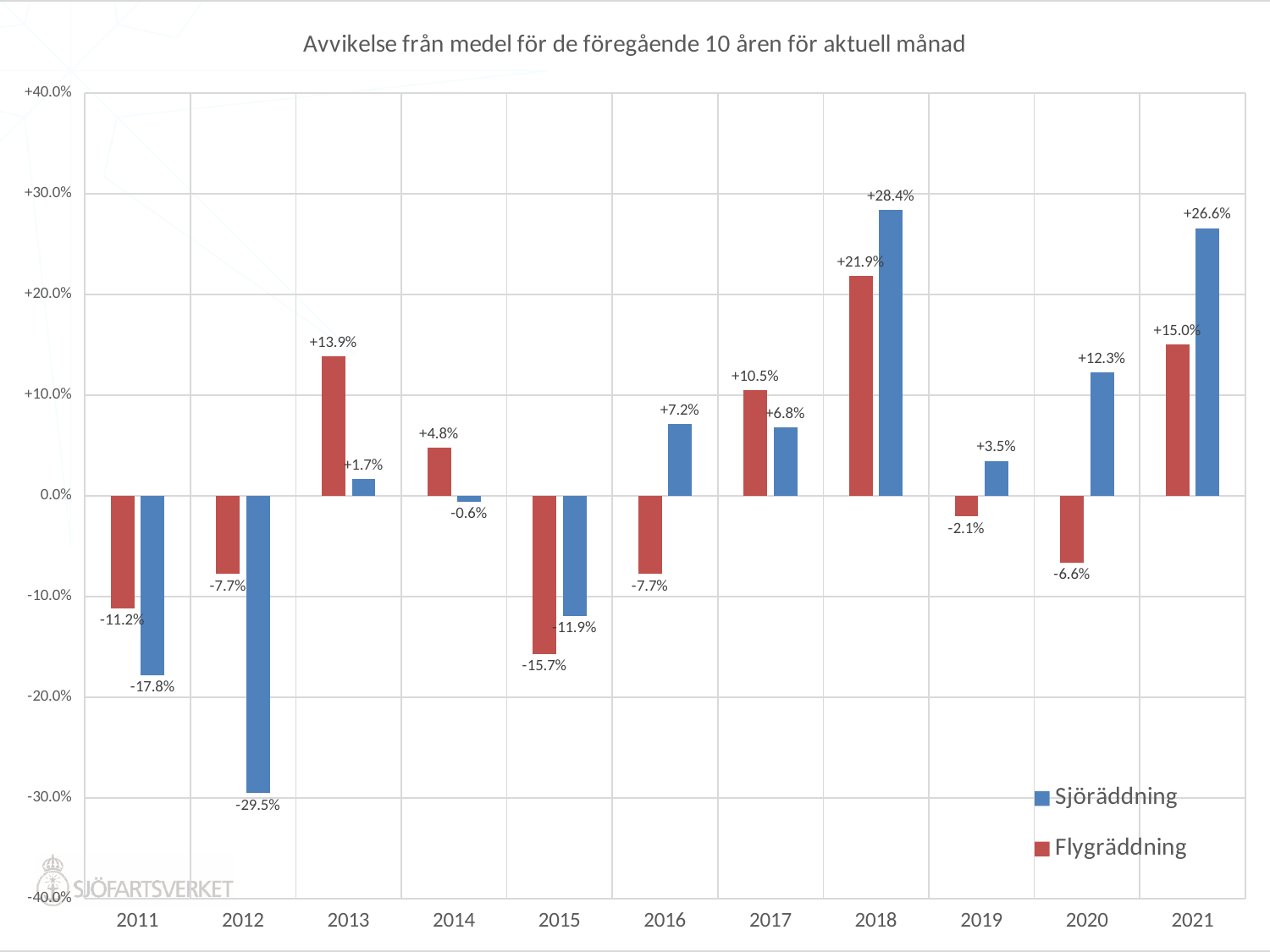
In which year is the Sjöräddning value lowest? 2012 What is the value for Sjöräddning in 2012? -29.5% In which year is the Flygräddning value highest? 2018 How many years are shown on the x axis? 11 Which series has the larger value in 2017, Sjöräddning or Flygräddning? Flygräddning What is the value for Sjöräddning in 2021? +26.6% How many series does the legend list? 2 In which year is the Sjöräddning value highest? 2018 What is the difference between the Sjöräddning and Flygräddning values in 2018? 6.5 percentage points What is the value for Flygräddning in 2018? +21.9% What type of chart is shown on the slide? Bar chart What is the value for Flygräddning in 2015? -15.7%